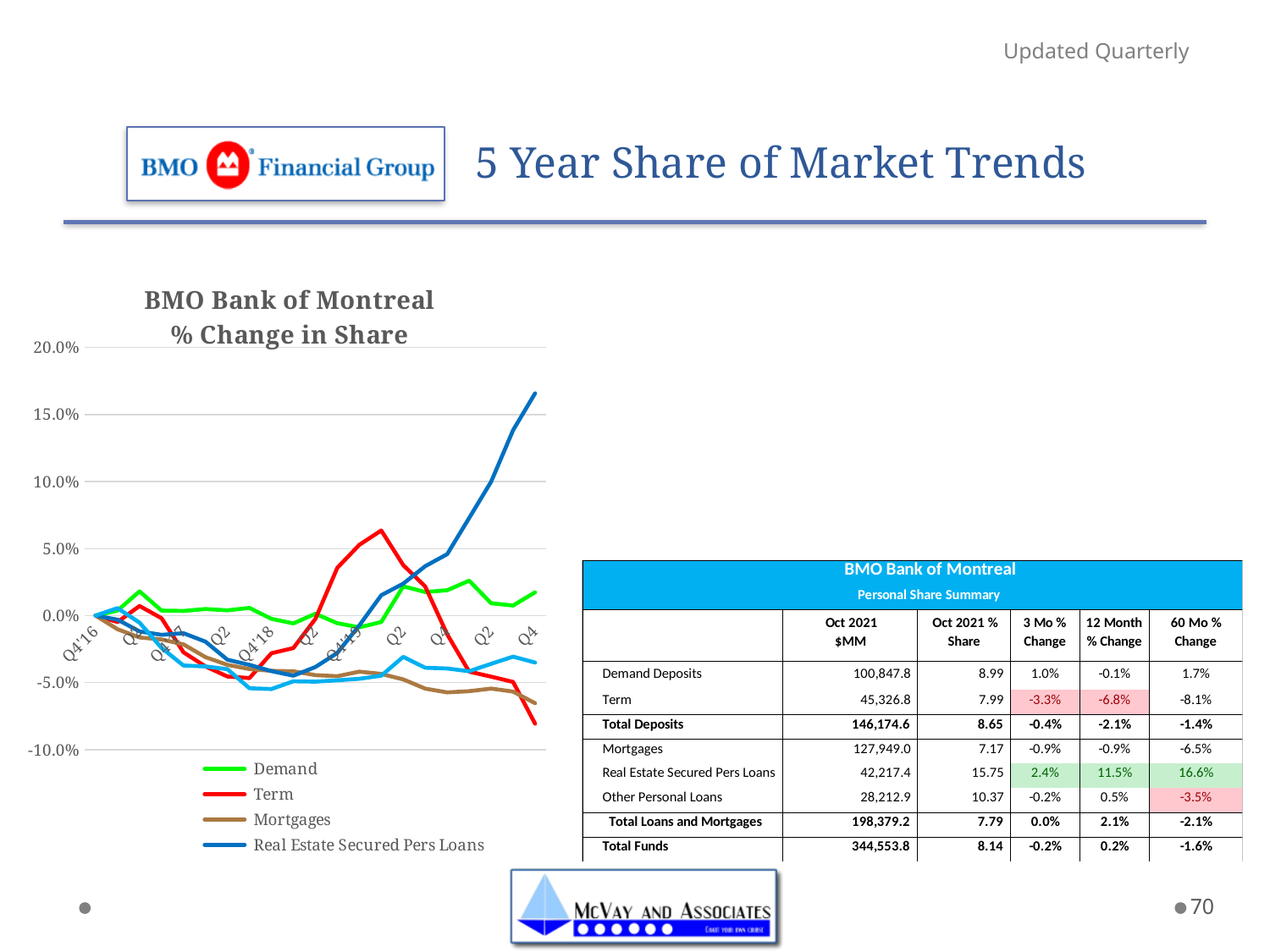
In the "% Change in Share" chart, which series has the highest value at the final quarter on the x axis? Real Estate Secured Pers Loans In the "% Change in Share" chart, is the value for Mortgages at the final quarter greater or less than -5.0%? less What colour is the Demand line in the "% Change in Share" chart? green What kind of chart is the "BMO Bank of Montreal % Change in Share" chart? line chart In the "% Change in Share" chart, which series reaches the highest value anywhere on the chart? Real Estate Secured Pers Loans In the "% Change in Share" chart, which series has the lowest value at the final quarter on the x axis? Term What is the title of the chart on the left of the slide? BMO Bank of Montreal % Change in Share In the "% Change in Share" chart, is the value for Demand at the final quarter greater or less than 0.0%? greater In the "% Change in Share" chart, is the value for Real Estate Secured Pers Loans at the final quarter greater or less than 15.0%? greater How many series does the legend of the "% Change in Share" chart list? 4 In the "% Change in Share" chart, does the Real Estate Secured Pers Loans line rise or fall over the last several quarters shown? rise